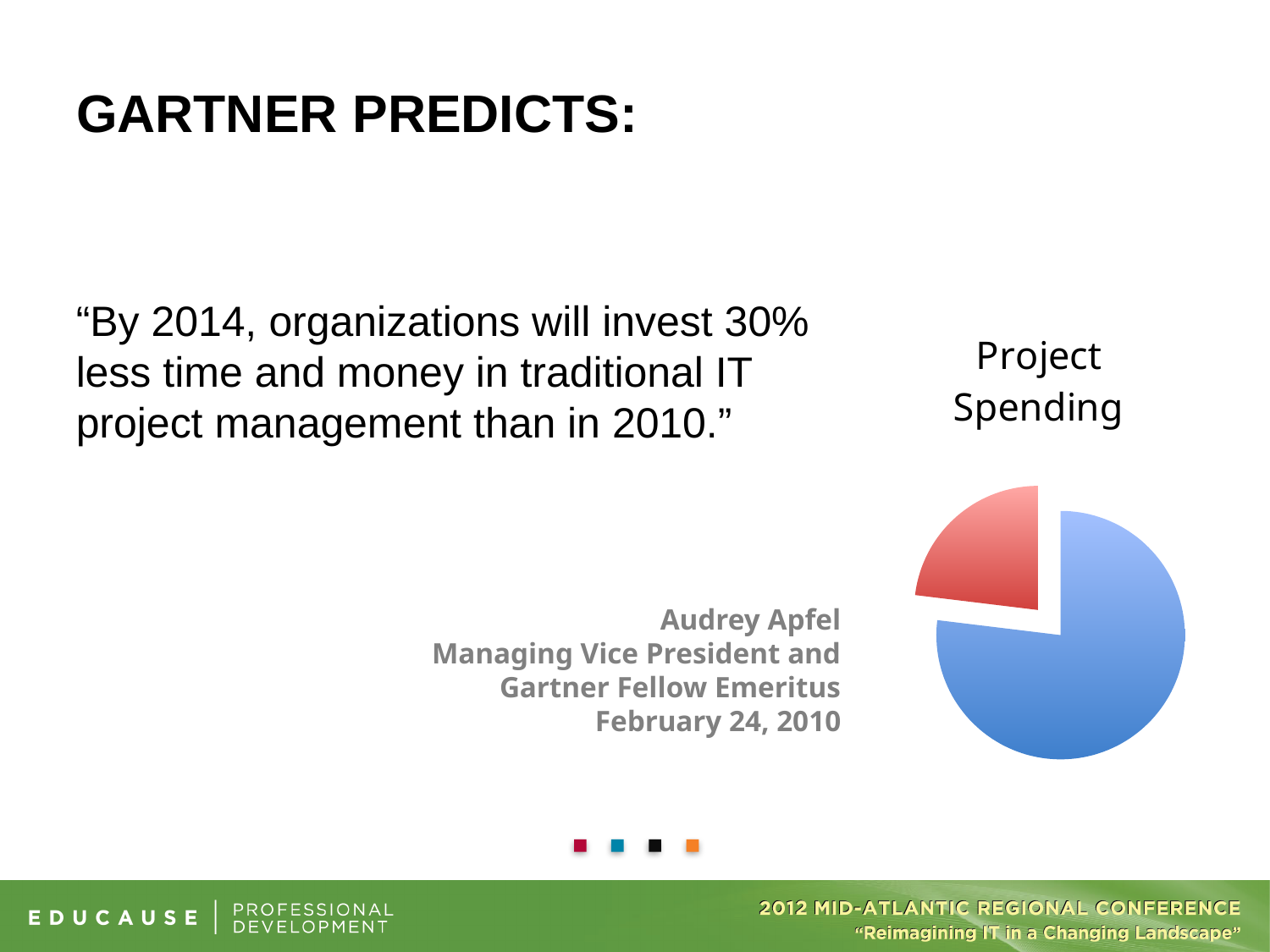
Which colour slice is the largest in the Project Spending pie chart? Blue How many slices does the Project Spending pie chart have? 2 What kind of chart is shown under the title "Project Spending"? Pie chart Which colour slice is the smallest in the Project Spending pie chart? Red In the Project Spending pie chart, which slice is larger, the blue one or the red one? Blue In the Project Spending pie chart, which slice is pulled out from the rest of the pie? The red slice What is the title of the chart on the slide? Project Spending